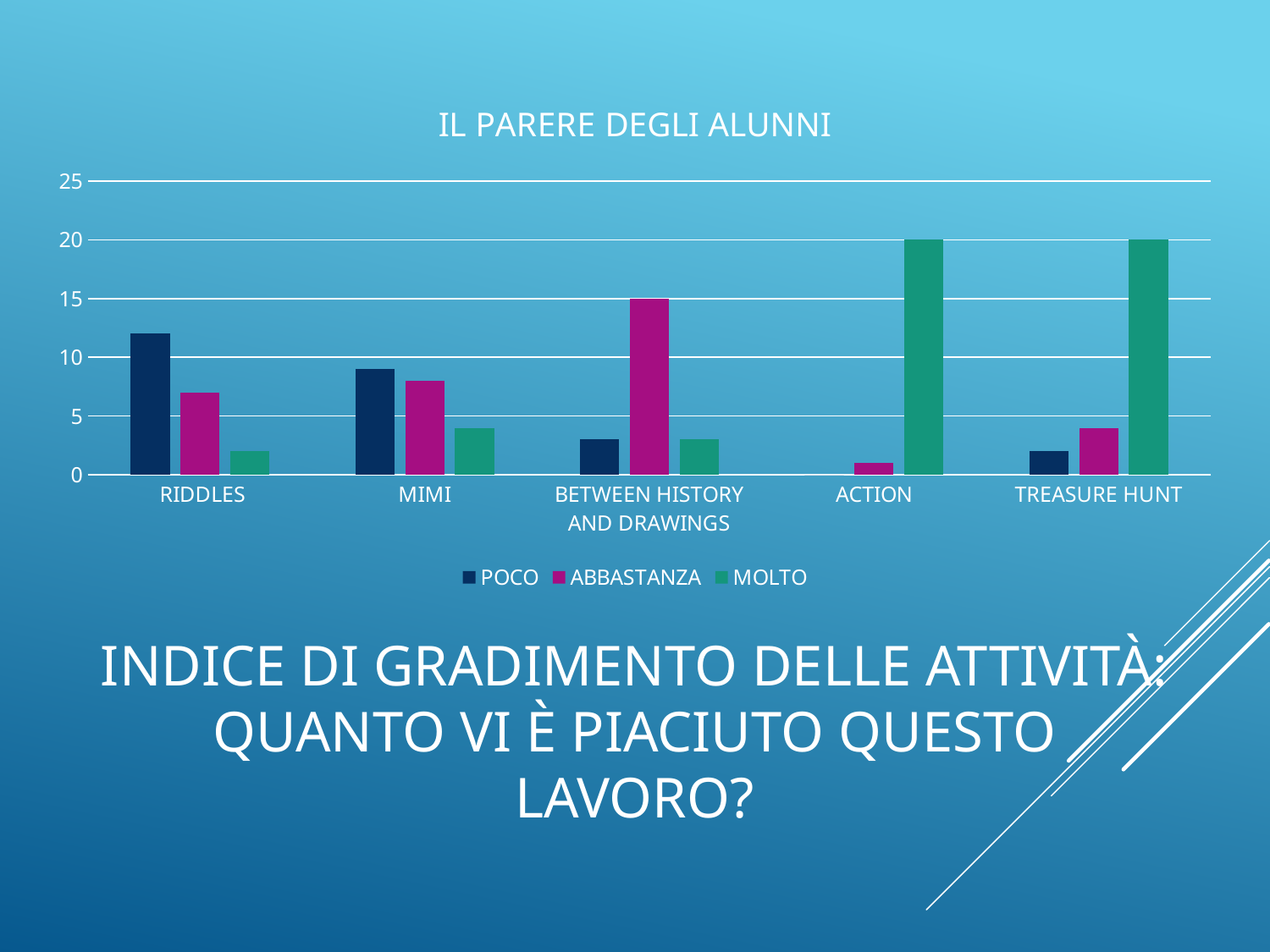
How many activity categories are shown on the x axis? 5 Which is larger: the ABBASTANZA value for BETWEEN HISTORY AND DRAWINGS or the ABBASTANZA value for RIDDLES? BETWEEN HISTORY AND DRAWINGS What is the MOLTO value for TREASURE HUNT? 20 How many series does the legend list? 3 What kind of chart is shown on the slide? bar chart What is the ABBASTANZA value for BETWEEN HISTORY AND DRAWINGS? 15 Which category has the highest POCO value? RIDDLES What is the MOLTO value for ACTION? 20 Which category has the lowest MOLTO value? RIDDLES What is the title of the chart? IL PARERE DEGLI ALUNNI Is the POCO value for RIDDLES greater or less than 10? greater Is the MOLTO value for MIMI greater or less than 5? less